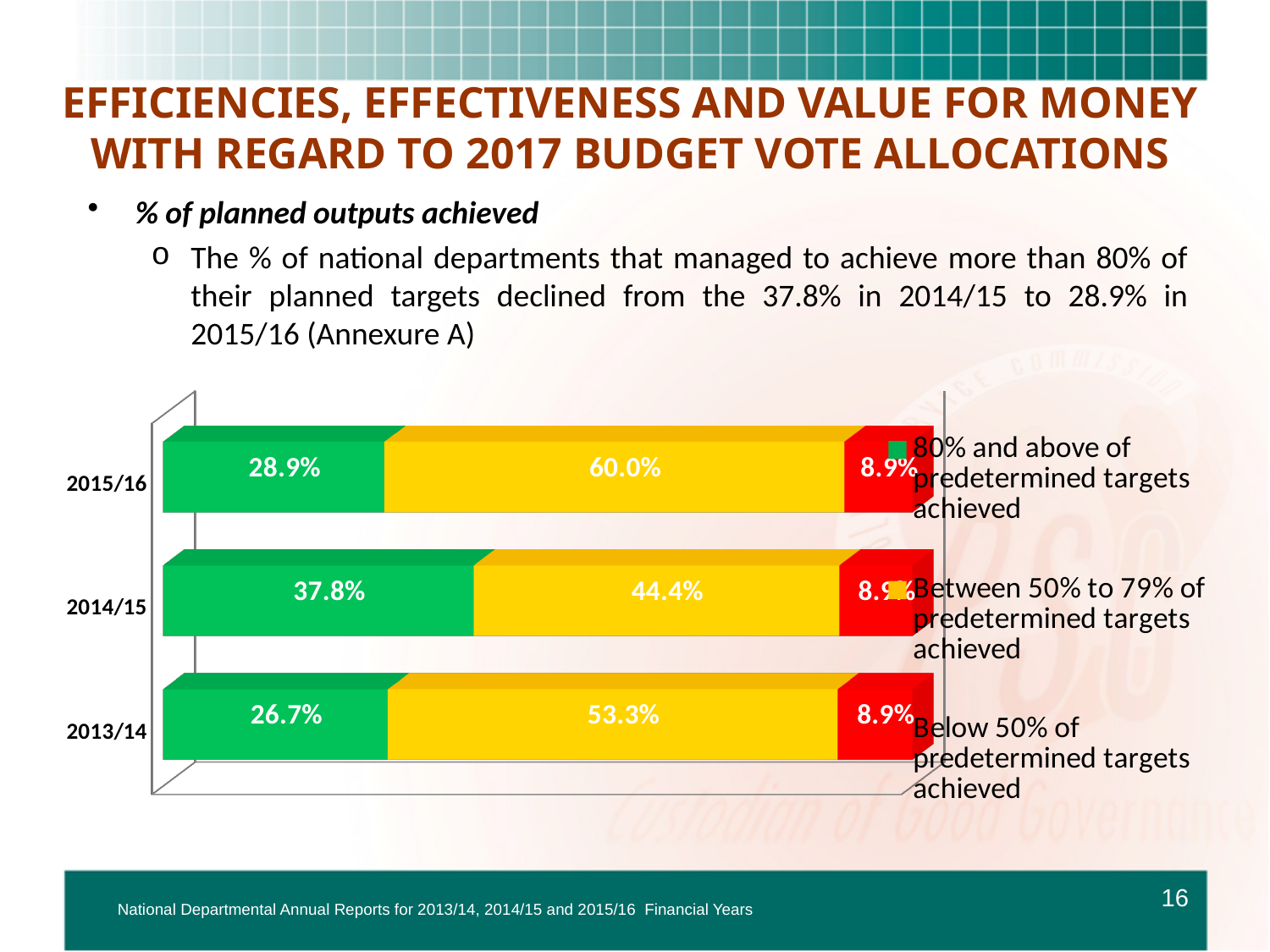
Which year has the larger value for 'Between 50% to 79% of predetermined targets achieved', 2015/16 or 2013/14? 2015/16 Which financial year has the highest value for '80% and above of predetermined targets achieved'? 2014/15 What colour represents '80% and above of predetermined targets achieved' in the chart? Green How many series does the chart's legend list? 3 What is the value for 'Between 50% to 79% of predetermined targets achieved' in 2014/15? 44.4% Which financial year has the lowest value for '80% and above of predetermined targets achieved'? 2013/14 What is the value for 'Below 50% of predetermined targets achieved' in 2013/14? 8.9% What percentage of departments achieved 80% and above of predetermined targets in 2015/16? 28.9% In 2015/16, what is the difference between the 'Between 50% to 79%' value and the '80% and above' value? 31.1 percentage points How many financial years (categories) are plotted in the chart? 3 What kind of chart is shown on the slide? Stacked bar chart By how many percentage points did the '80% and above' value fall from 2014/15 to 2015/16? 8.9 percentage points